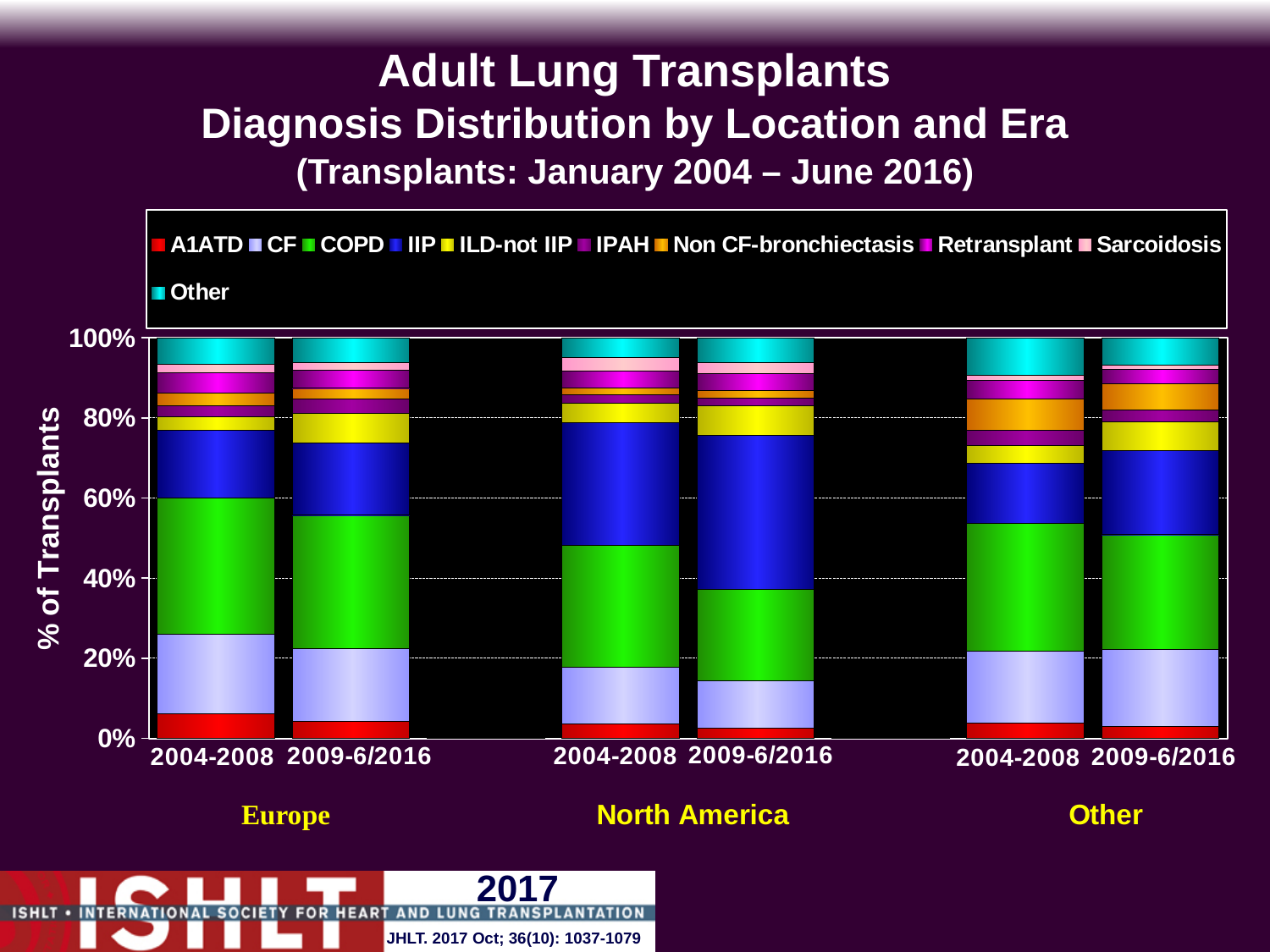
In North America, does the IIP share rise or fall from 2004-2008 to 2009-6/2016? Rise Which is larger: the IIP share for North America 2009-6/2016 or the IIP share for Europe 2004-2008? North America 2009-6/2016 Which is larger: the COPD share for Europe 2004-2008 or the COPD share for North America 2009-6/2016? Europe 2004-2008 How many location groups are shown along the x axis? 3 Which of the six bars has the largest IIP segment? North America 2009-6/2016 In North America, does the COPD share rise or fall from 2004-2008 to 2009-6/2016? Fall How many stacked bars are plotted on the chart? 6 What is the title of the chart? Adult Lung Transplants Diagnosis Distribution by Location and Era (Transplants: January 2004 – June 2016) How many series does the legend list? 10 What is the label of the y axis? % of Transplants What kind of chart is shown on the slide? Stacked bar chart What does each stacked bar total? 100%